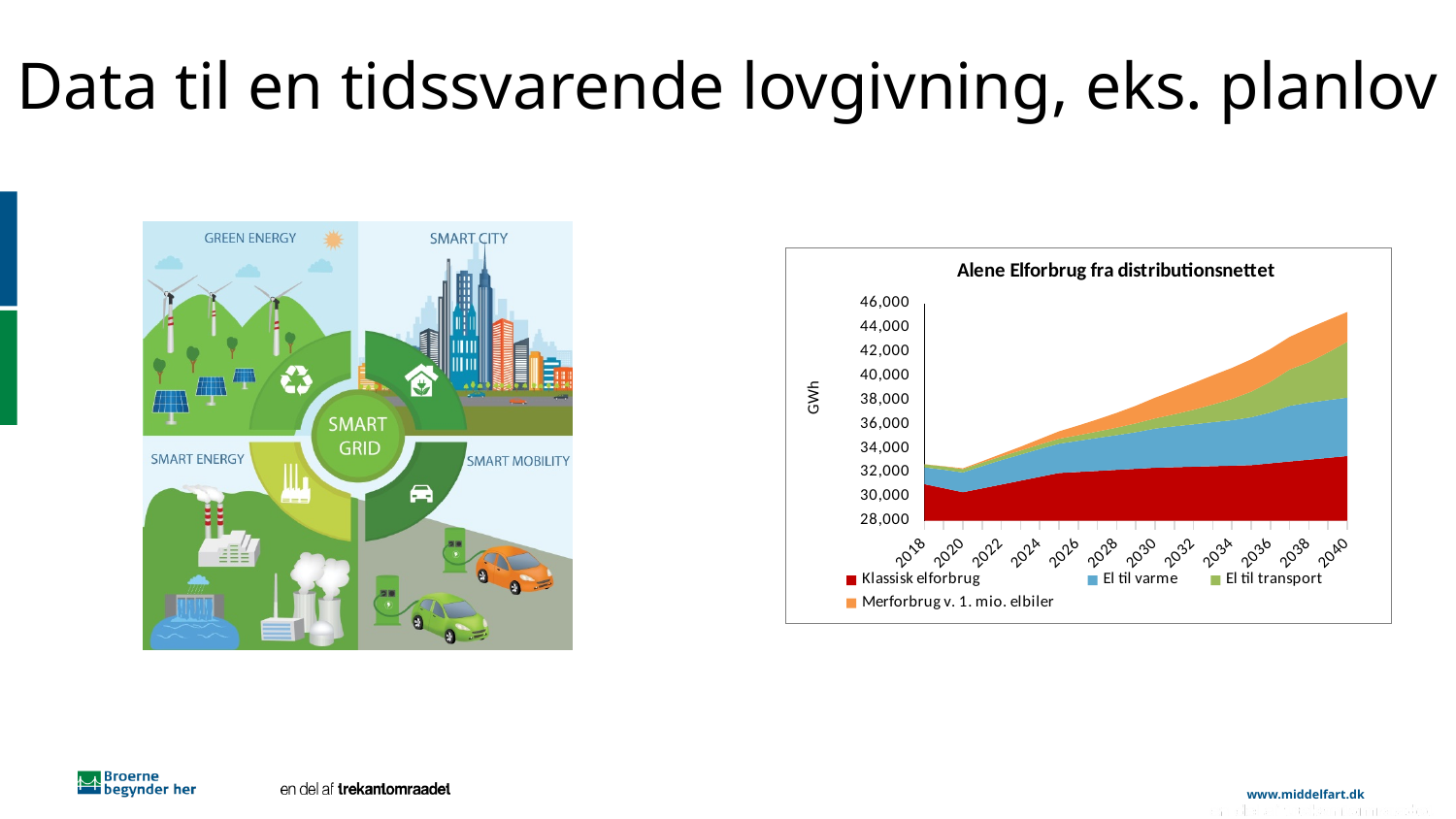
Is the total value for 2040 greater or less than 44,000? greater What kind of chart is shown on the slide? Stacked area chart What is the title of the chart? Alene Elforbrug fra distributionsnettet In which year is the total consumption in the chart highest? 2040 How many year labels are shown on the x-axis of the chart? 12 How many series does the chart's legend list? 4 What unit is shown on the y-axis of the chart? GWh Which series accounts for the largest share of consumption in the chart? Klassisk elforbrug Is the total value for 2018 greater or less than 30,000? greater Is the value for Klassisk elforbrug in 2020 greater or less than 32,000? less Does the total electricity consumption in the chart rise or fall from 2018 to 2040? Rise